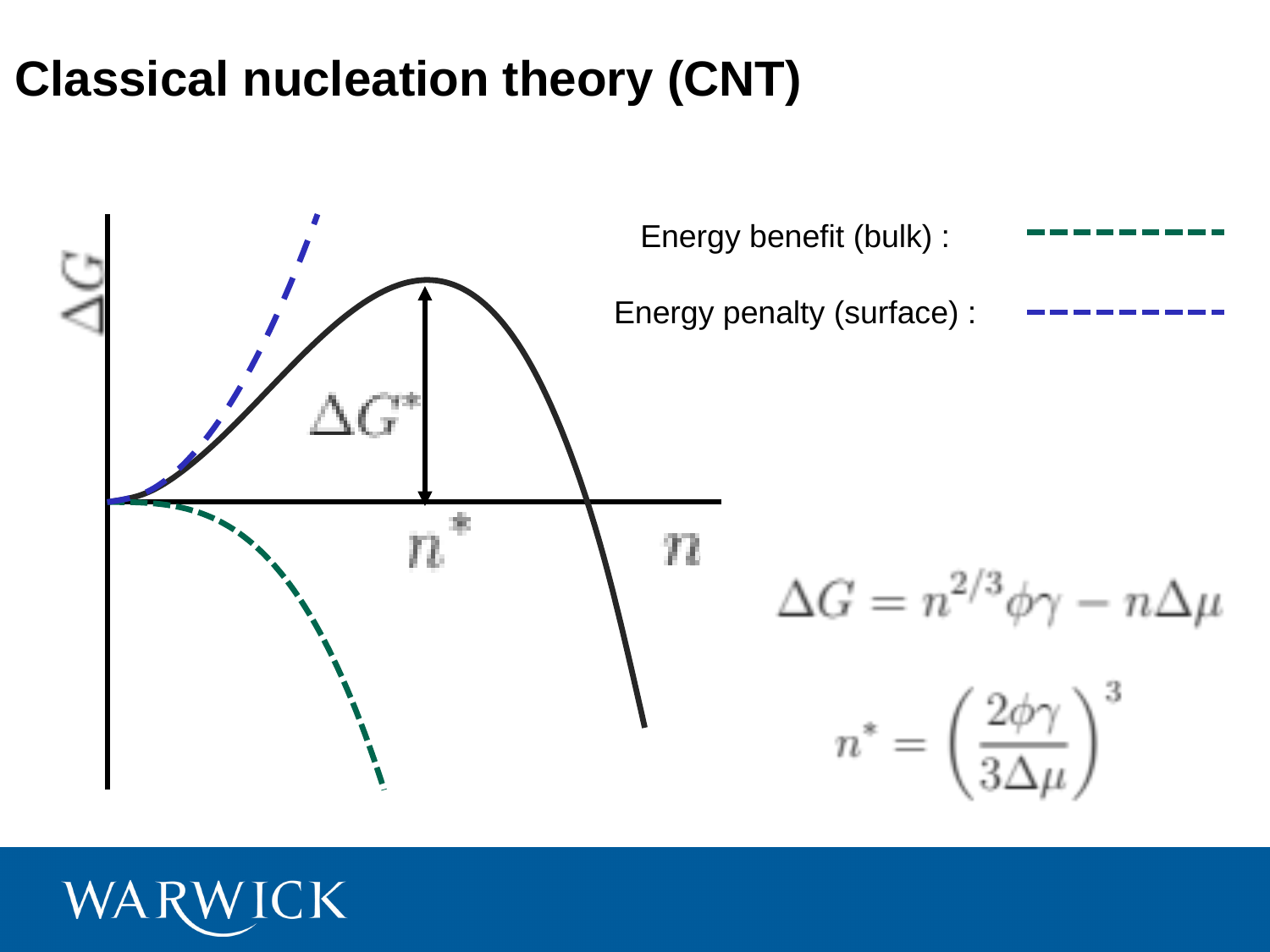
Does the blue dashed curve (energy penalty, surface) rise or fall as n increases? rise According to the legend, which quantity is shown by the green dashed line? Energy benefit (bulk) How many entries does the legend list? 2 What is the label on the vertical axis of the chart? ΔG What kind of chart is shown on the slide? line chart How many curves are plotted on the chart? 3 What label marks the height of the peak of the solid black curve? ΔG* How does the solid black curve behave as n increases? rises to a peak then falls Does the green dashed curve (energy benefit, bulk) rise or fall as n increases? fall At the right side of the chart, which curve is higher: the blue dashed curve or the green dashed curve? blue dashed curve What is the label on the horizontal axis of the chart? n According to the legend, which quantity is shown by the blue dashed line? Energy penalty (surface)